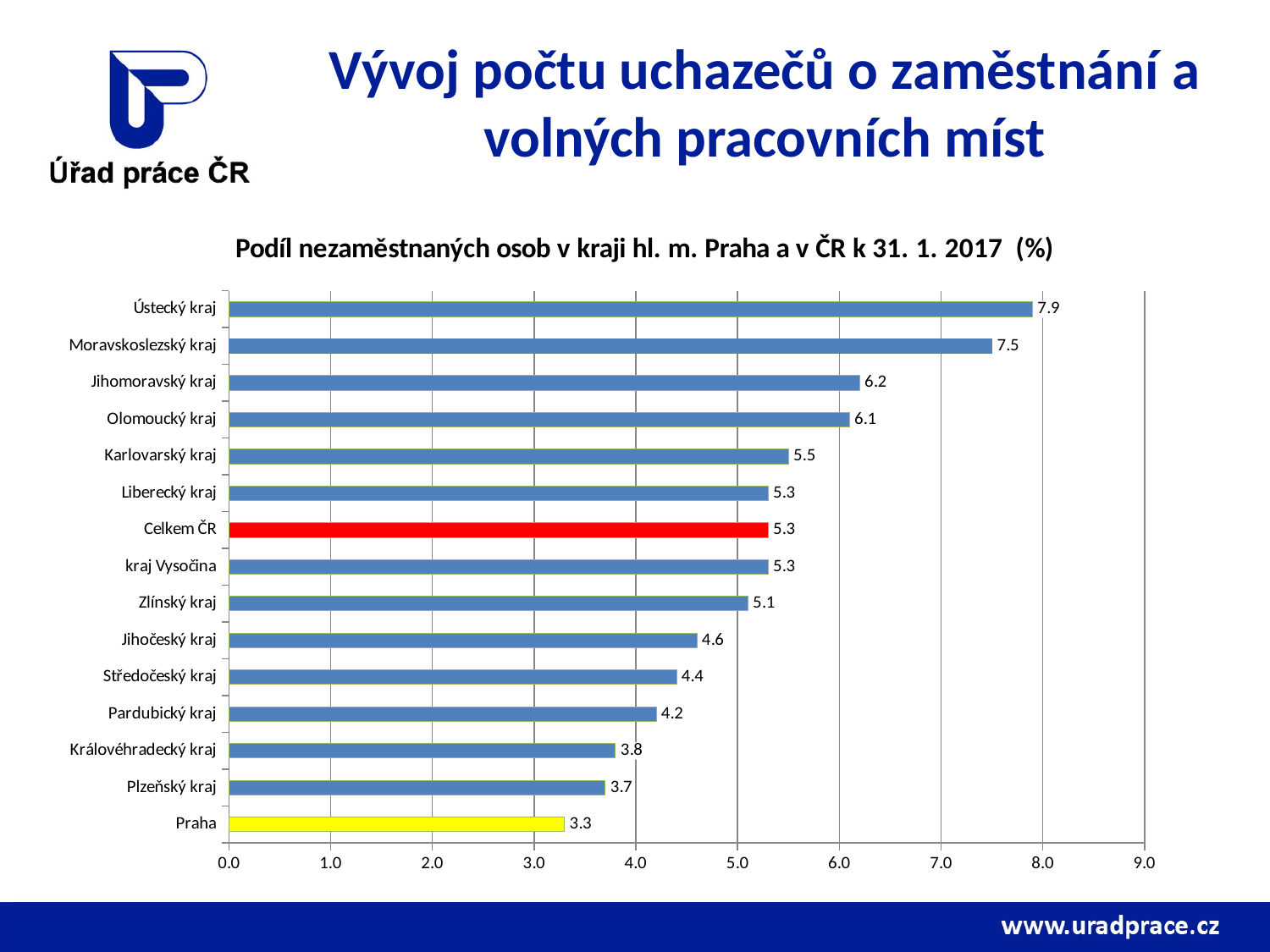
Which is larger, the value for Karlovarský kraj or the value for Jihočeský kraj? Karlovarský kraj What colour is the bar for Celkem ČR? red How many categories are shown on the chart? 15 What is the difference between the values for Moravskoslezský kraj and Jihomoravský kraj? 1.3 What is the difference between the values for Ústecký kraj and Praha? 4.6 What is the value for Celkem ČR? 5.3 Which category has the lowest value? Praha What is the value for Praha? 3.3 What kind of chart is shown on the slide? bar chart What is the value for Pardubický kraj? 4.2 Which category has the highest value? Ústecký kraj What is the value for Ústecký kraj? 7.9